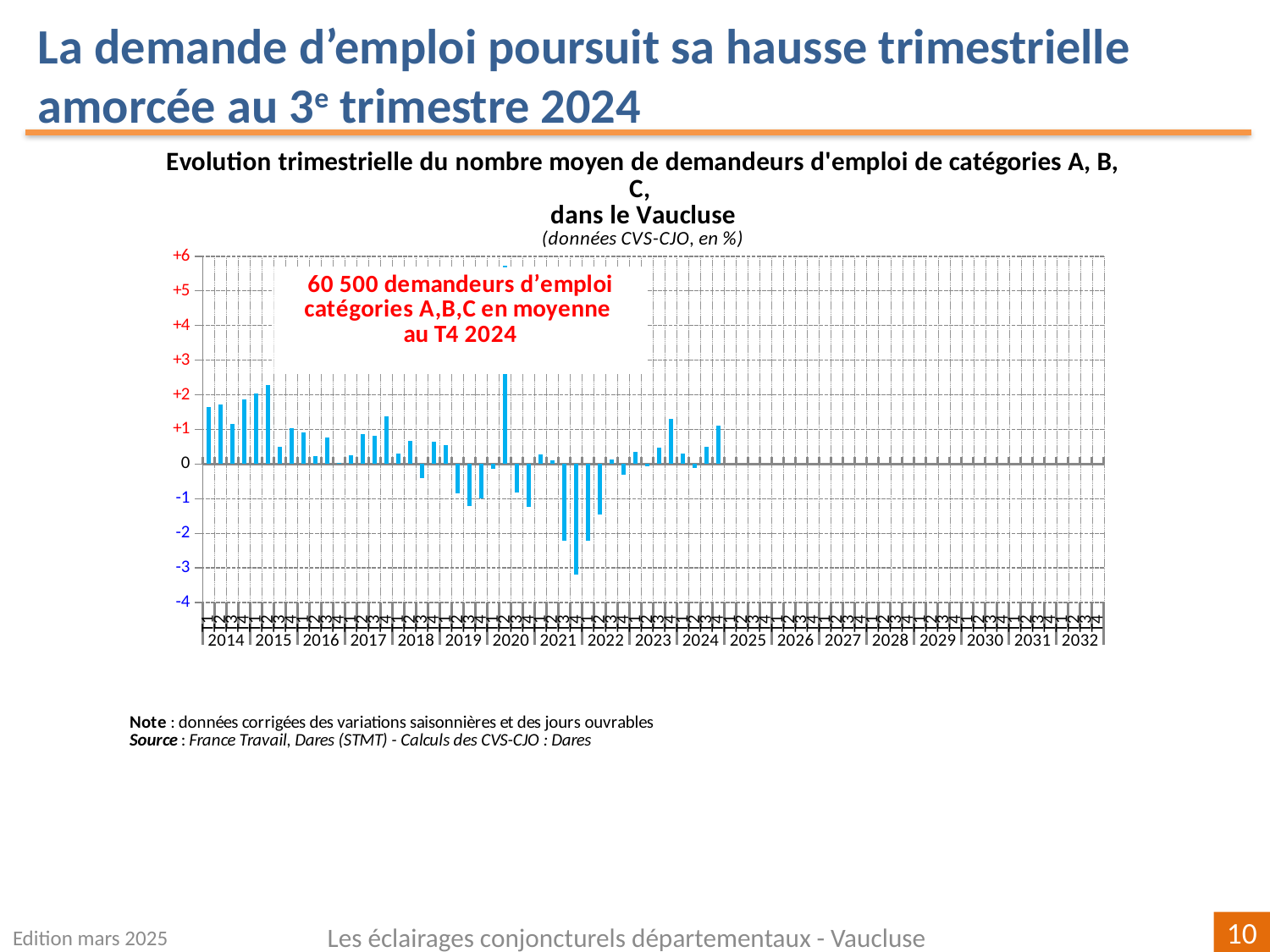
Is the last bar of 2024 greater or less than +2? less Which is lower: the lowest bar of 2021 or the lowest bar of 2022? the lowest bar of 2021 Is the last bar of 2024 greater or less than 0? greater Over the last three quarters of 2021, do the bars rise or fall? fall In which year does the chart's highest bar occur? 2020 Is the highest bar in 2020 greater or less than +3? greater Which is larger: the first bar of 2014 or the last bar of 2024? the first bar of 2014 What kind of chart is shown on the slide? bar chart In which year does the chart's lowest bar occur? 2021 According to the text box on the chart, how many demandeurs d'emploi catégories A,B,C were there on average in T4 2024? 60 500 How many years are labelled on the x axis? 19